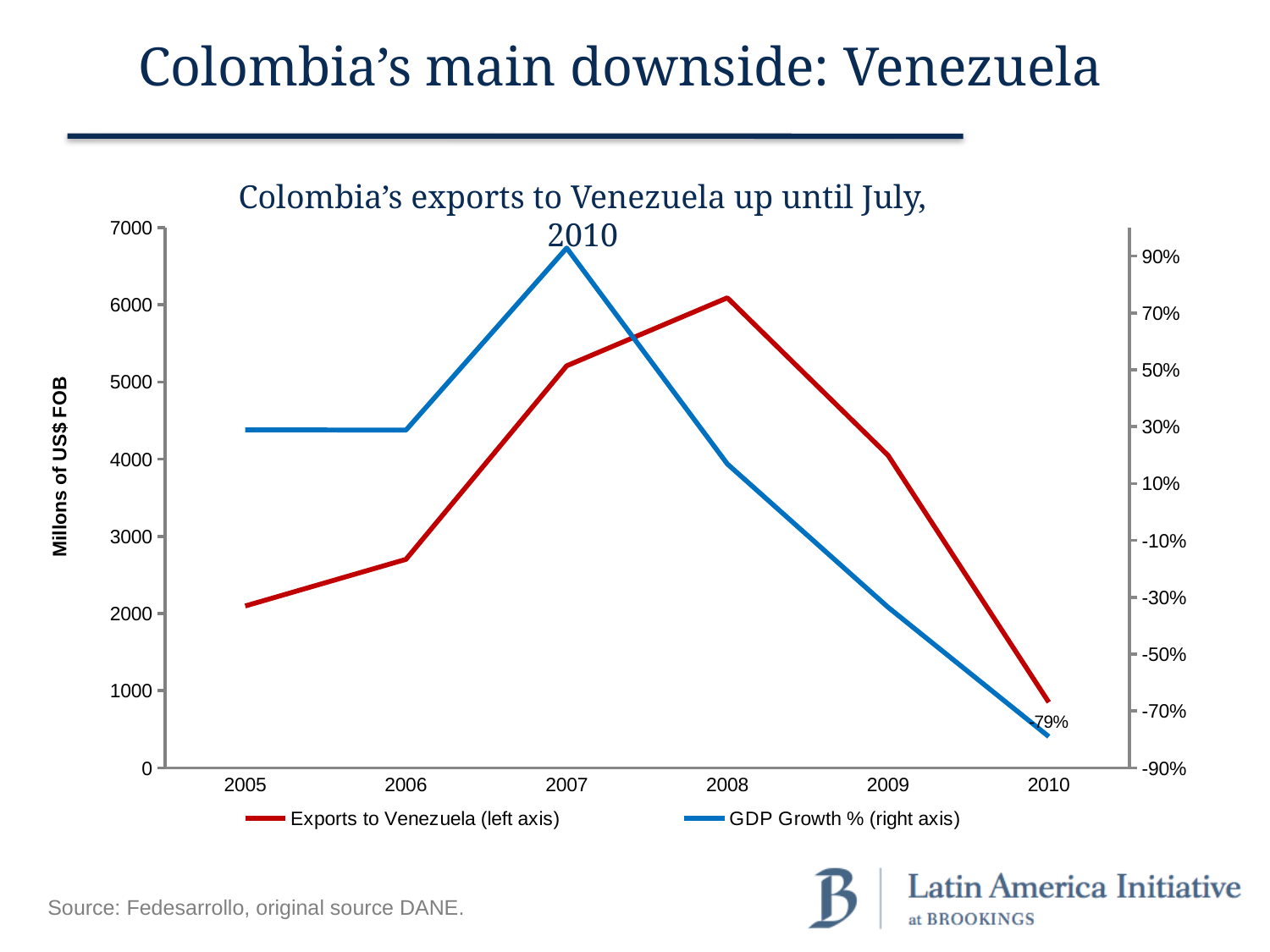
How many series does the legend list? 2 Is the value for GDP Growth % in 2009 greater or less than 10%? less In which year is GDP Growth % lowest? 2010 Is the value for Exports to Venezuela in 2005 greater or less than 3000? less Is the value for Exports to Venezuela in 2008 greater or less than 5000? greater In which year is GDP Growth % highest? 2007 In which year do Exports to Venezuela reach their highest value? 2008 What kind of chart is shown on the slide? line chart Do Exports to Venezuela rise or fall from 2008 to 2010? fall In which year are Exports to Venezuela lowest? 2010 Which is larger, Exports to Venezuela in 2006 or in 2009? 2009 How many years are plotted along the x axis? 6